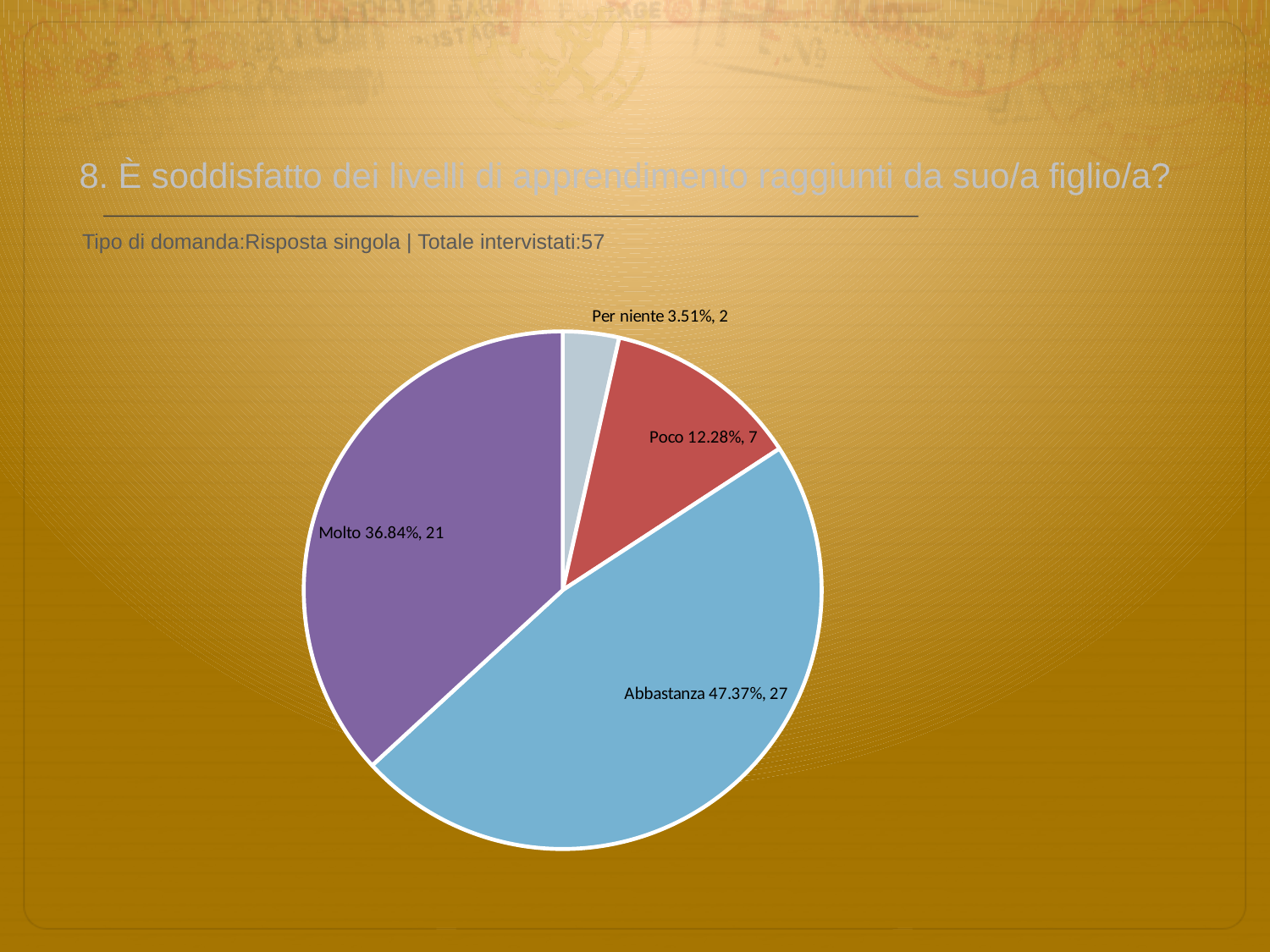
What percentage share does the 'Per niente' slice have? 3.51% Which category has the largest slice? Abbastanza How many slices does the pie chart have? 4 Which has more respondents, 'Poco' or 'Per niente'? Poco What is the total number of respondents across all slices? 57 What percentage share does the 'Abbastanza' slice have? 47.37% What is the difference in respondent count between 'Abbastanza' and 'Molto'? 6 What kind of chart is shown on the slide? pie chart What colour is the 'Molto' slice? purple How many respondents answered 'Molto'? 21 How many respondents answered 'Poco'? 7 Which category has the smallest slice? Per niente